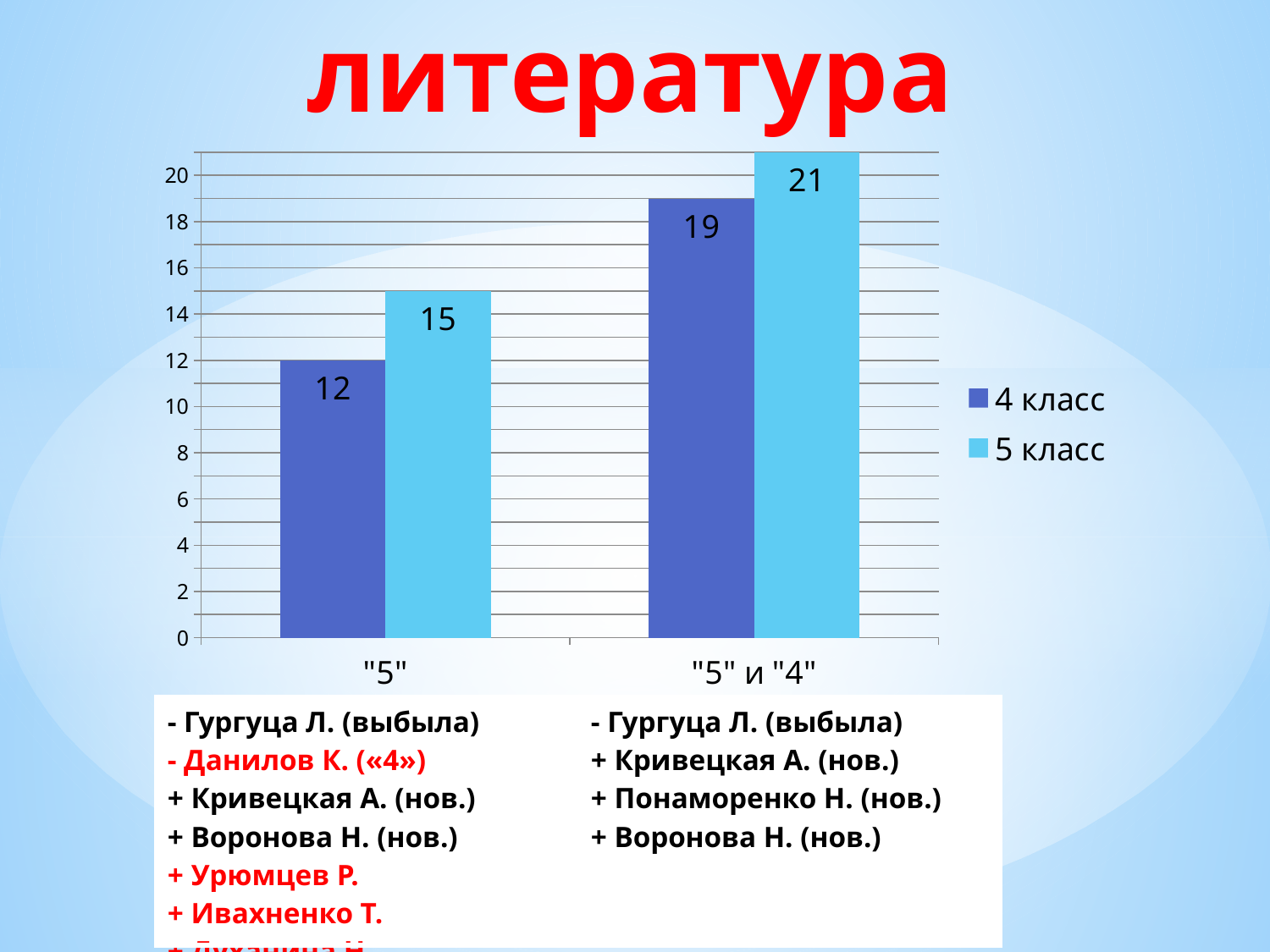
Which category has the highest value for "5 класс"? "5" и "4" What is the value for "4 класс" in the "5" и "4" category? 19 Which is larger: the "4 класс" value for "5" or the "5 класс" value for "5"? 5 класс What is the difference between the "4 класс" values in the "5" и "4" category and the "5" category? 7 What kind of chart is shown on the slide? bar chart Which category has the lowest value for "4 класс"? "5" What is the value for "5 класс" in the "5" и "4" category? 21 How many categories are shown on the x axis? 2 How many series does the legend list? 2 What is the difference between the "5 класс" and "4 класс" values in the "5" и "4" category? 2 What is the value for "4 класс" in the "5" category? 12 What is the value for "5 класс" in the "5" category? 15